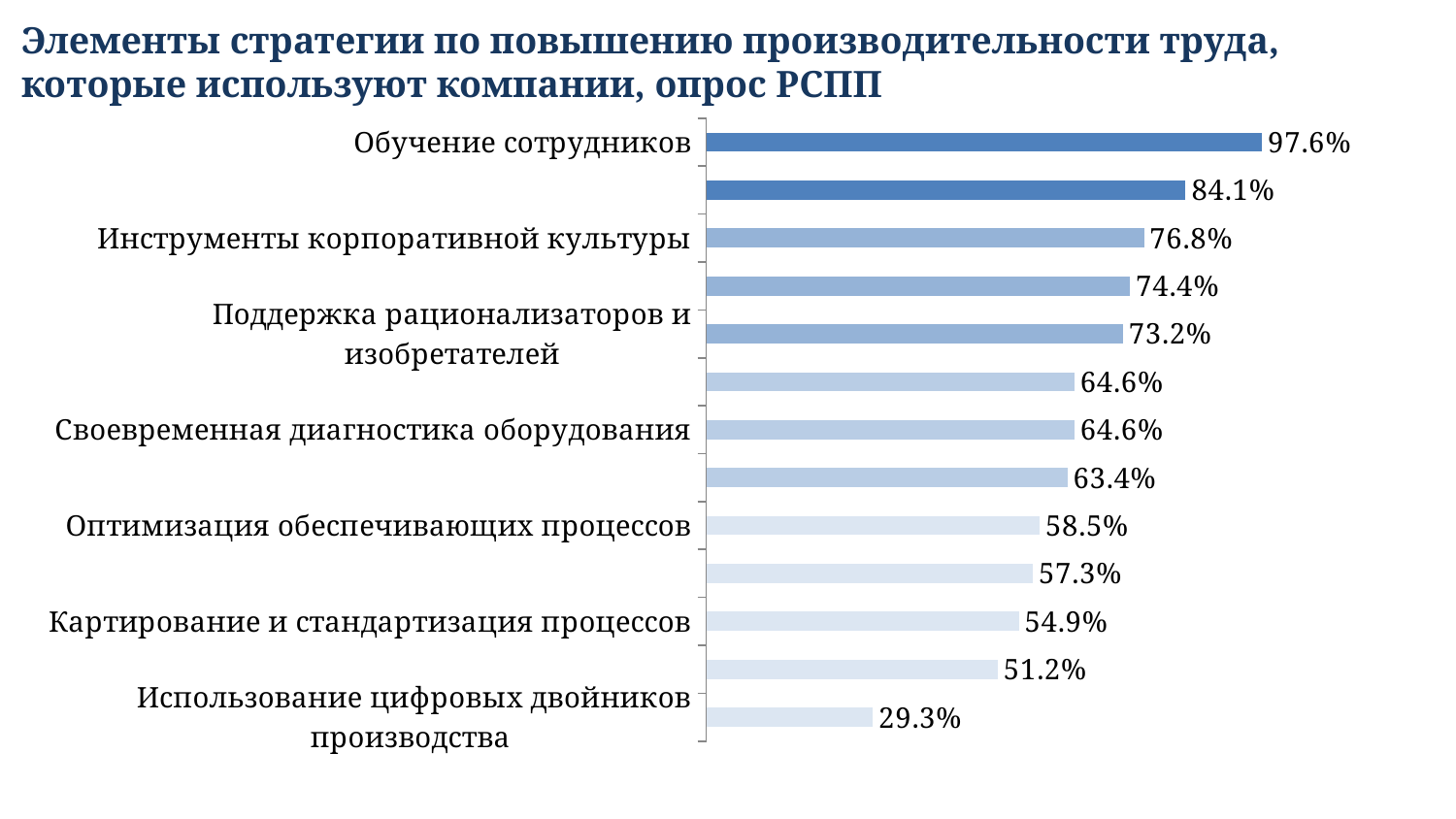
Which category has the highest value? Обучение сотрудников What is the value for Обучение сотрудников? 97.6% What is the value for Использование цифровых двойников производства? 29.3% What is the difference between the values for Обучение сотрудников and Использование цифровых двойников производства? 68.3 percentage points Which category has the lowest value? Использование цифровых двойников производства What kind of chart is shown on the slide? Bar chart What is the value for Инструменты корпоративной культуры? 76.8% Which is larger: the value for Оптимизация обеспечивающих процессов or the value for Картирование и стандартизация процессов? Оптимизация обеспечивающих процессов What is the value for Своевременная диагностика оборудования? 64.6% What is the value for Картирование и стандартизация процессов? 54.9% What is the value for Поддержка рационализаторов и изобретателей? 73.2% How many bars are plotted in the chart? 13